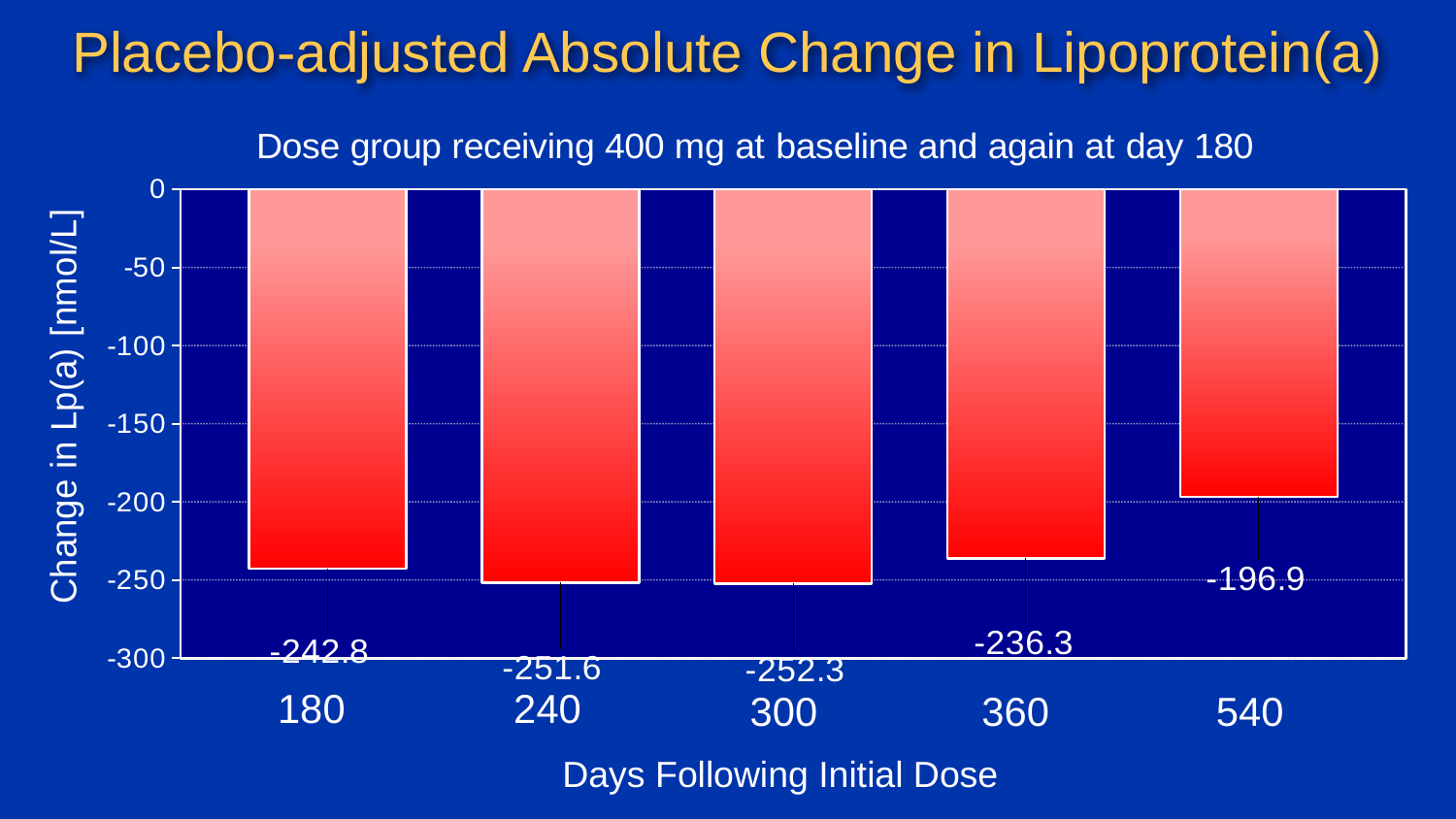
What is the placebo-adjusted change in Lp(a) at 180 days following the initial dose? -242.8 From day 300 to day 540, do the plotted values rise or fall? Rise What is the value shown for 540 days following the initial dose? -196.9 What is the difference between the values at day 180 and day 540? 45.9 Which has a larger reduction in Lp(a): day 240 or day 360? Day 240 Is the value for day 540 greater or less than -200? greater At which number of days following the initial dose is the change in Lp(a) least negative (closest to zero)? 540 What is the label on the vertical axis? Change in Lp(a) [nmol/L] At which number of days following the initial dose is the change in Lp(a) most negative? 300 What kind of chart is shown on the slide? Bar chart What is the change in Lp(a) at day 360? -236.3 How many time points (days following initial dose) are plotted? 5